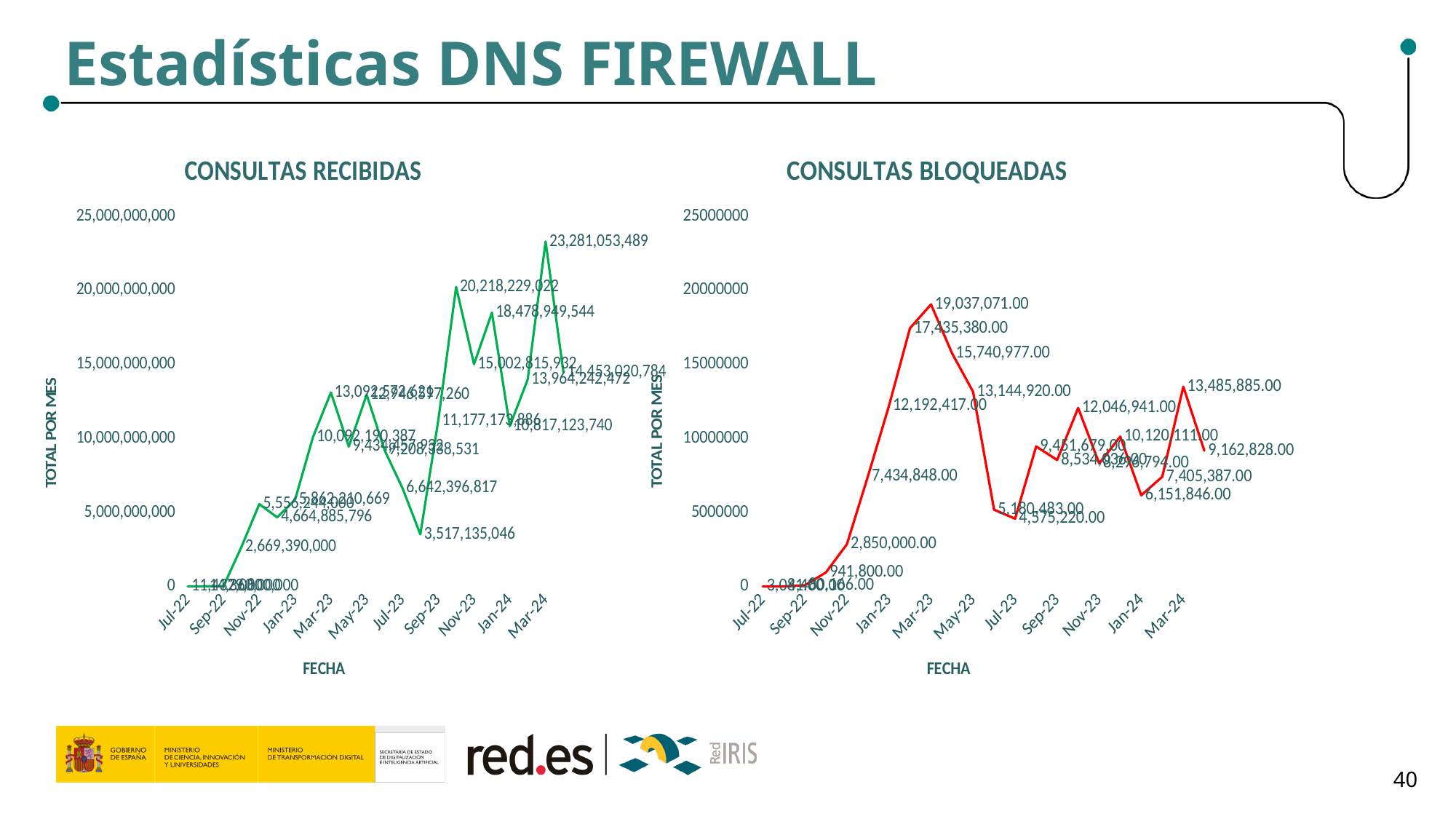
Which is larger: the peak value in the CONSULTAS RECIBIDAS chart or the peak value in the CONSULTAS BLOQUEADAS chart? CONSULTAS RECIBIDAS In the CONSULTAS BLOQUEADAS chart, is the value for Jul-22 greater or less than 5000000? less What kind of chart is the CONSULTAS RECIBIDAS chart on the left? line chart What kind of chart is the CONSULTAS BLOQUEADAS chart on the right? line chart In the CONSULTAS RECIBIDAS chart, what is the highest value plotted? 23,281,053,489 In the CONSULTAS BLOQUEADAS chart, is the value for Mar-23 greater or less than 15000000? greater In the CONSULTAS RECIBIDAS chart, is the value for Jul-22 greater or less than 5,000,000,000? less In the CONSULTAS BLOQUEADAS chart, do the values rise or fall between Jul-22 and Mar-23? rise What is the x-axis title of the CONSULTAS BLOQUEADAS chart? FECHA What colour is the line in the CONSULTAS RECIBIDAS chart? green In the CONSULTAS BLOQUEADAS chart, what is the difference between the highest value (19,037,071.00) and the second-highest value (17,435,380.00)? 1,601,691.00 In the CONSULTAS BLOQUEADAS chart, what is the highest value plotted? 19,037,071.00